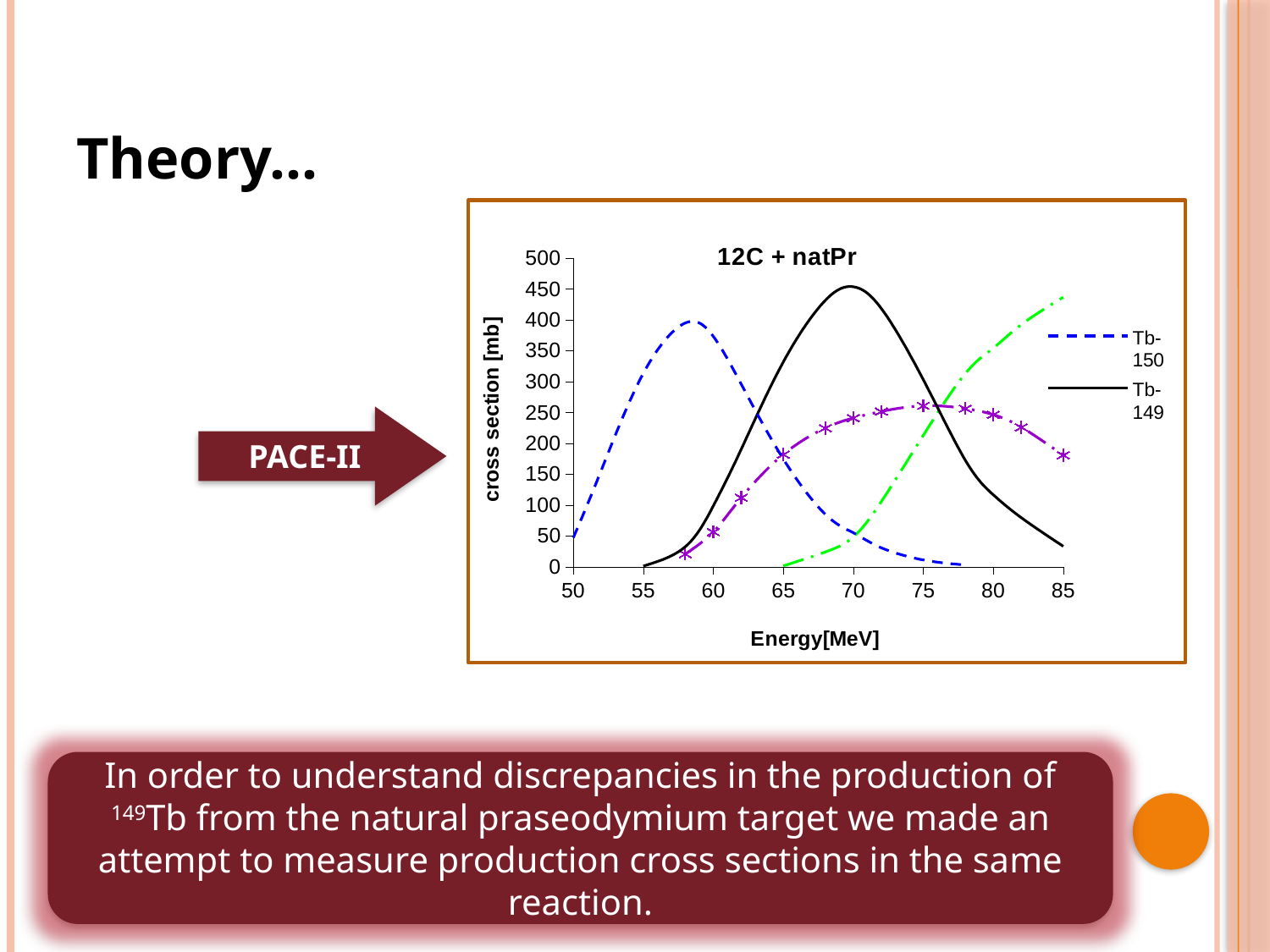
Does the Tb-150 curve rise or fall as energy increases from 60 MeV to 80 MeV? fall At 55 MeV, which series has the larger cross section, Tb-150 or Tb-149? Tb-150 How many series does the chart's legend list? 2 Is the value of the Tb-150 curve at 65 MeV greater or less than 150? greater At 70 MeV, which series has the larger cross section, Tb-150 or Tb-149? Tb-149 Is the value of the Tb-149 curve at 85 MeV greater or less than 50? less What is the title of the chart? 12C + natPr What is the label of the x axis of the chart? Energy[MeV] Is the peak value of the Tb-149 curve greater or less than 400? greater What kind of chart is shown on the slide? line chart Which of the two legend series reaches the higher peak cross section? Tb-149